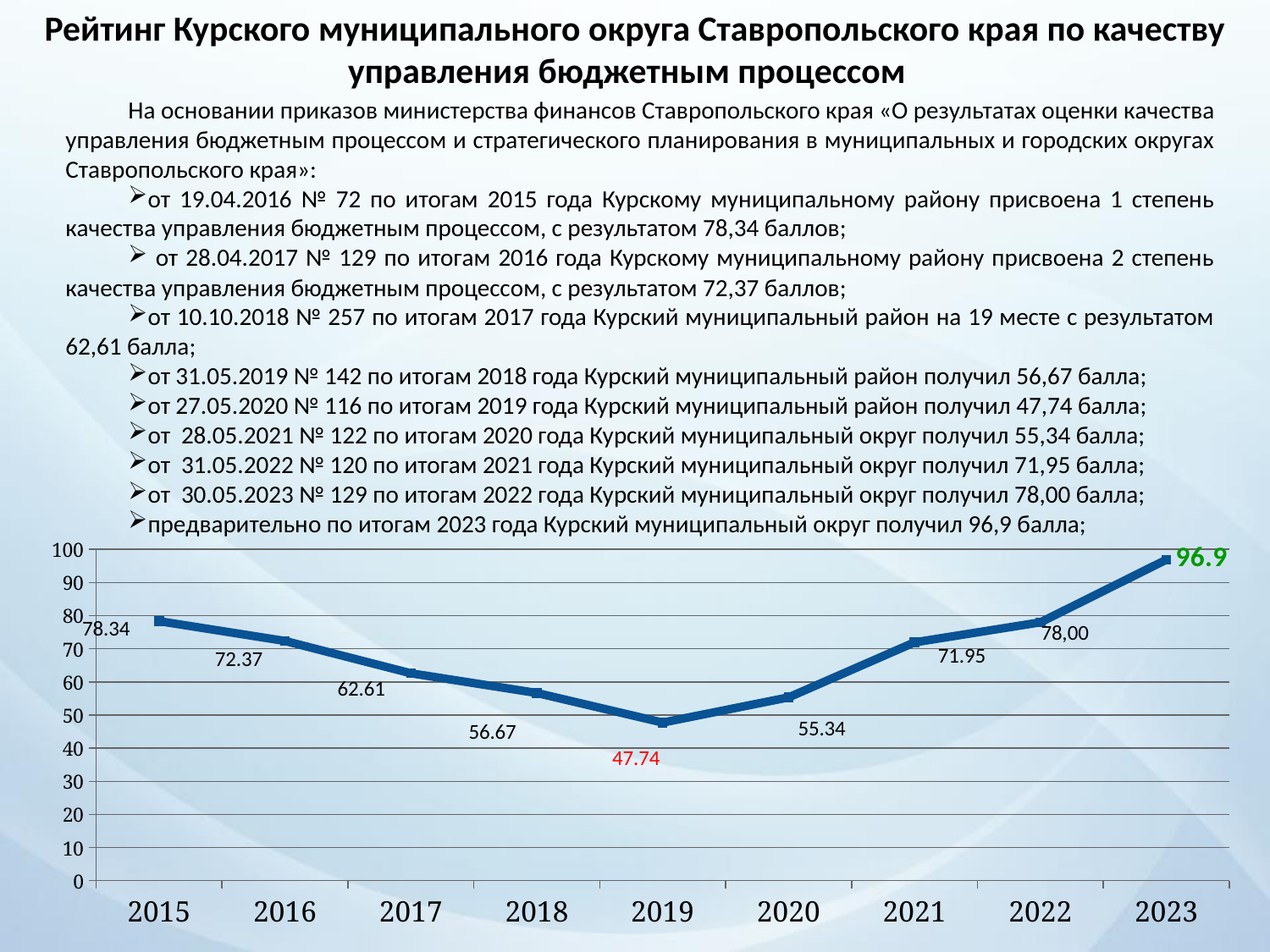
Which is larger, the value for 2016 or the value for 2021? 2016 Which year has the lowest value on the chart? 2019 What is the difference between the values for 2023 and 2022? 18.9 How many years are plotted on the x axis? 9 What is the difference between the values for 2015 and 2019? 30.6 What value is plotted for 2019? 47.74 Do the values rise or fall from 2019 to 2023? rise What value is plotted for 2015? 78.34 What kind of chart is shown on the slide? line chart What value is plotted for 2022? 78,00 Which year has the highest value on the chart? 2023 What value is plotted for 2023? 96.9